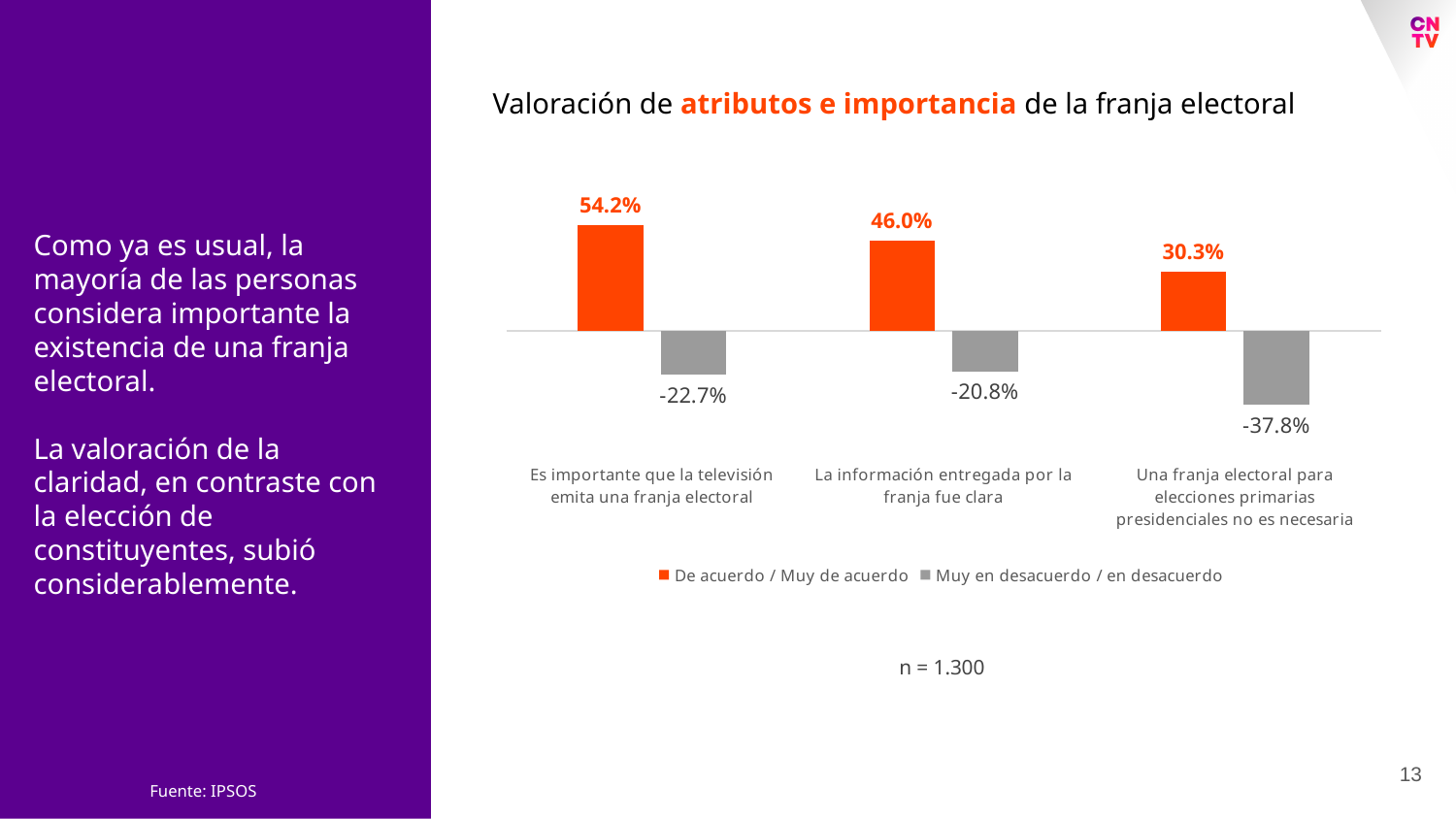
Which category has the lowest 'De acuerdo / Muy de acuerdo' value? Una franja electoral para elecciones primarias presidenciales no es necesaria What is the 'Muy en desacuerdo / en desacuerdo' value for 'La información entregada por la franja fue clara'? -20.8% How many categories are shown on the chart? 3 What is the 'Muy en desacuerdo / en desacuerdo' value for 'Una franja electoral para elecciones primarias presidenciales no es necesaria'? -37.8% Which category has the highest 'De acuerdo / Muy de acuerdo' value? Es importante que la televisión emita una franja electoral What colour are the 'De acuerdo / Muy de acuerdo' bars? Orange What kind of chart is shown on the slide? Bar chart What is the 'De acuerdo / Muy de acuerdo' value for 'La información entregada por la franja fue clara'? 46.0% What is the difference between the 'De acuerdo / Muy de acuerdo' values for 'Es importante que la televisión emita una franja electoral' and 'La información entregada por la franja fue clara'? 8.2% How many series does the legend list? 2 What is the 'De acuerdo / Muy de acuerdo' value for 'Es importante que la televisión emita una franja electoral'? 54.2% Which is larger in absolute terms: the 'Muy en desacuerdo / en desacuerdo' value for 'Es importante que la televisión emita una franja electoral' or for 'Una franja electoral para elecciones primarias presidenciales no es necesaria'? Una franja electoral para elecciones primarias presidenciales no es necesaria